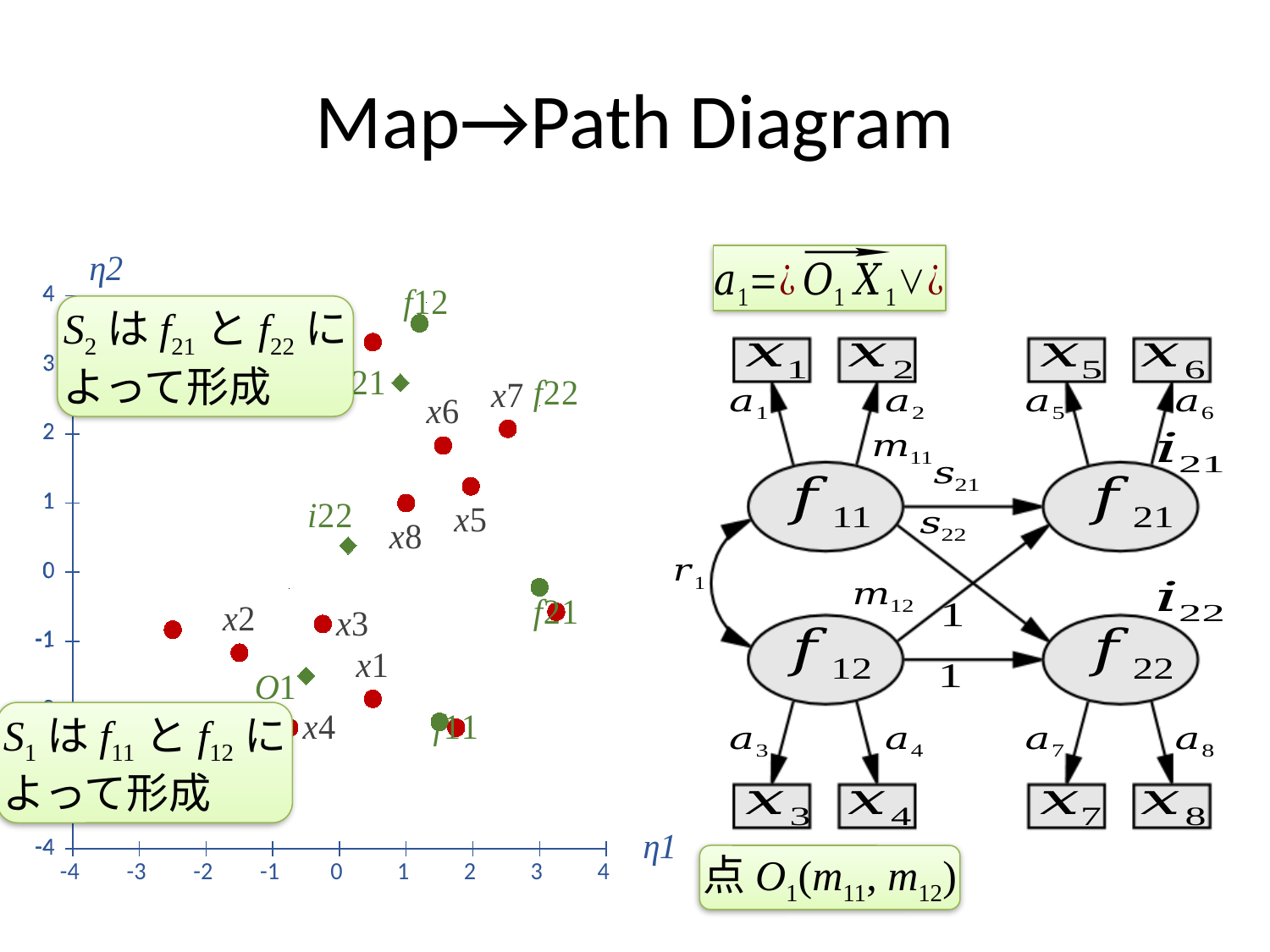
In the scatter chart, what are the labels of the horizontal and vertical axes? η1 and η2 In the scatter chart, which point has the larger η1 value, x6 or x1? x6 In the scatter chart, is the η2 value for x4 greater or less than -1? less In the scatter chart, is the η2 value for x1 greater or less than -1? less In the scatter chart, which point has the higher η2 value, x7 or x2? x7 In the scatter chart, what is the range of the η1 axis? -4 to 4 In the scatter chart, is the η2 value for x6 greater or less than 1? greater What kind of chart is shown on the left of the slide? scatter chart In the scatter chart, which of the points x1 to x8 has the lowest η2 value? x4